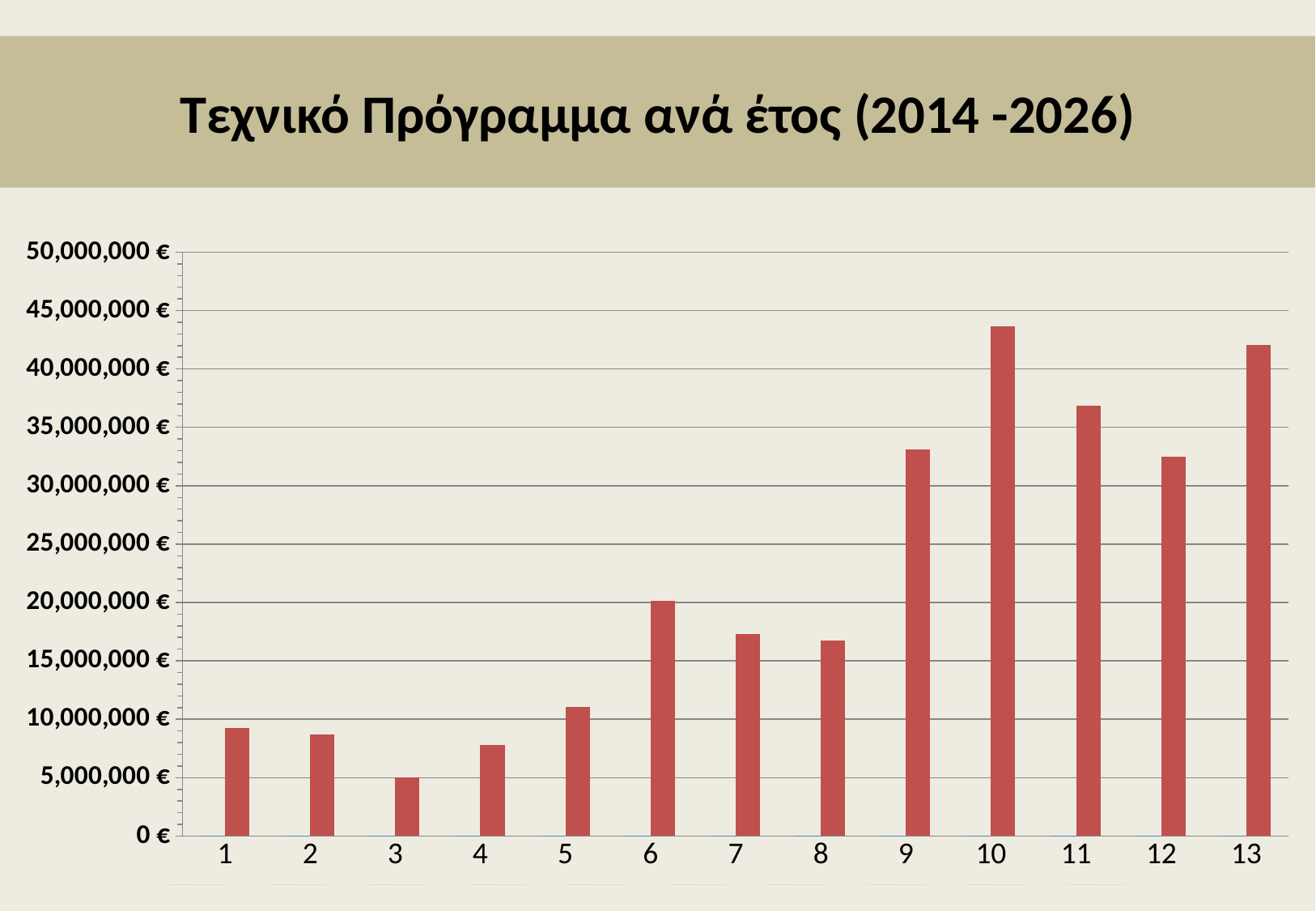
Which category has the lowest bar? 3 What kind of chart is shown on the slide? bar chart Which category has the highest bar? 10 Do the values generally rise or fall from category 1 to category 13? rise What is the title of the chart? Τεχνικό Πρόγραμμα ανά έτος (2014 -2026) Is the value for category 9 greater or less than 30,000,000 €? greater How many categories are plotted on the x axis? 13 Is the value for category 12 greater or less than 35,000,000 €? less Is the value for category 1 greater or less than 10,000,000 €? less Which is larger, the value for category 6 or category 7? 6 Which is larger, the value for category 11 or category 12? 11